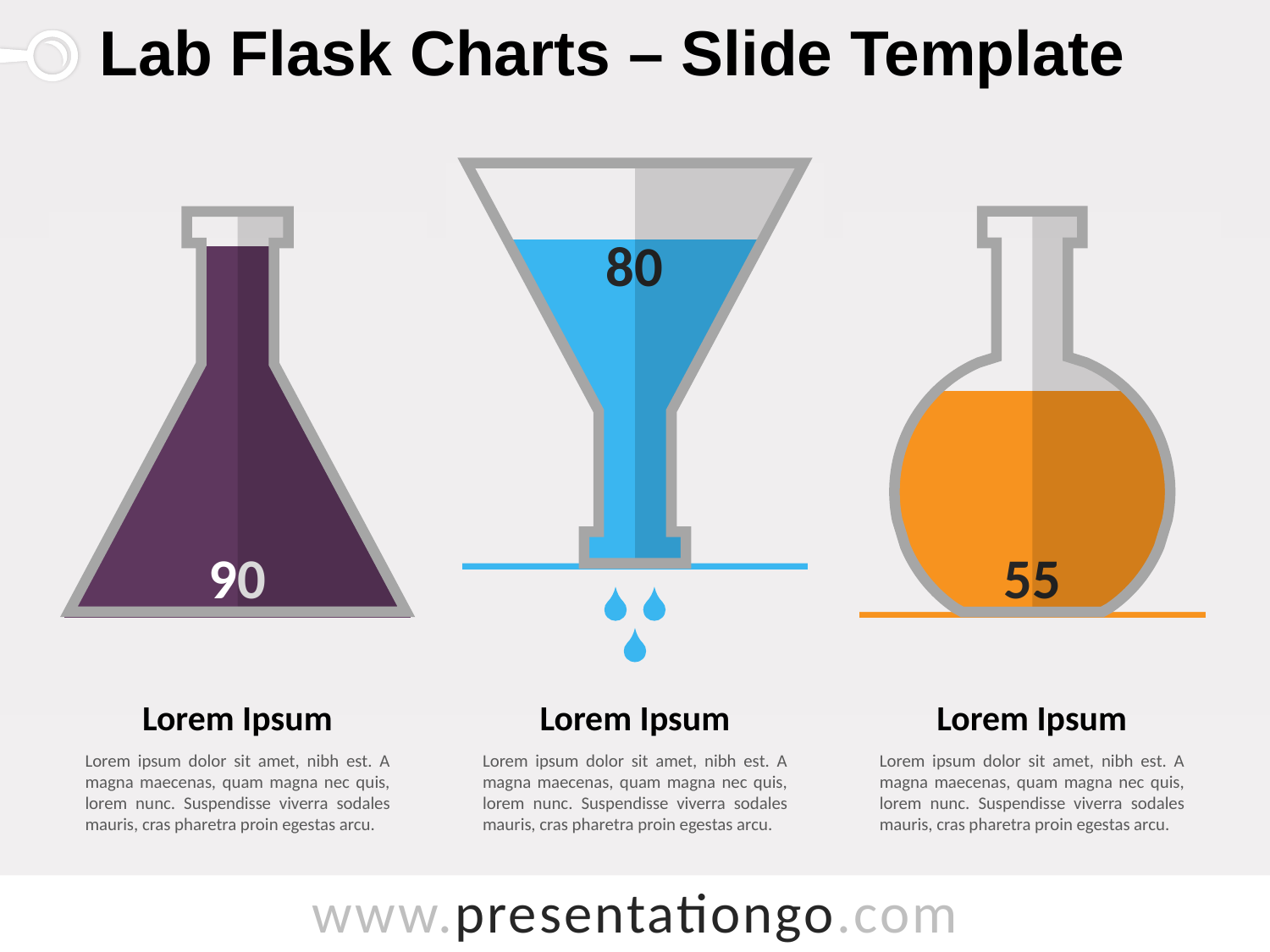
Which of the three flask charts shows the highest value? The left (purple) flask, 90 What is the title of the slide? Lab Flask Charts – Slide Template What is the difference between the value on the left flask and the value on the middle funnel? 10 Which is larger, the value on the middle funnel or the value on the right flask? The middle funnel (80) How many flask charts are shown on the slide? 3 What is the difference between the value on the left flask and the value on the right flask? 35 What value is shown on the middle chart (the blue funnel)? 80 Which of the three flask charts shows the lowest value? The right (orange) flask, 55 What is the difference between the value on the middle funnel and the value on the right flask? 25 What colour is the liquid in the middle funnel chart? Blue What value is shown on the left flask chart (the purple conical flask)? 90 What value is shown on the right flask chart (the orange round flask)? 55